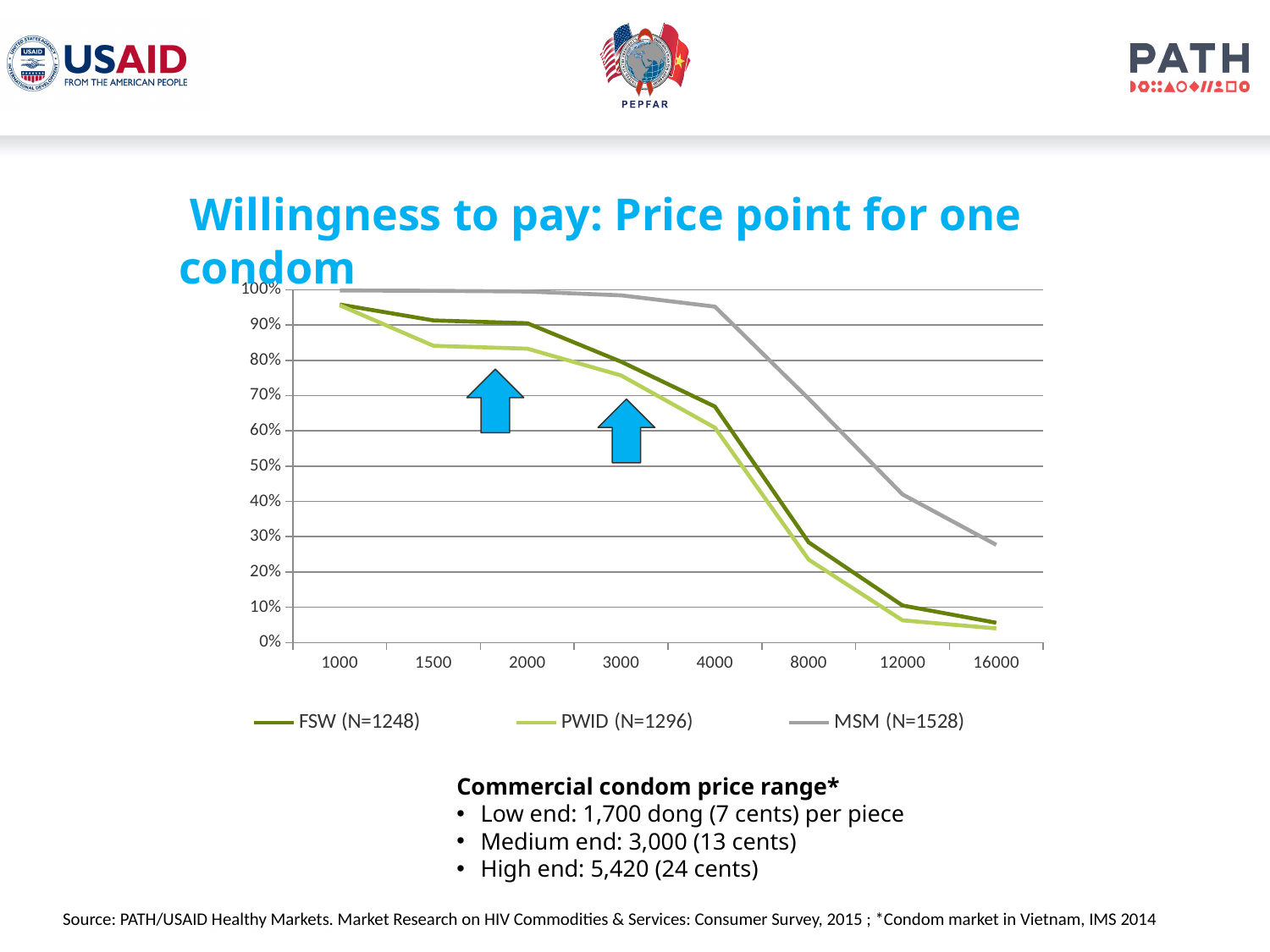
How many series does the legend list? 3 Is the value for PWID (N=1296) at the 1500 price point greater or less than 90%? less Do the values for the FSW (N=1248) series rise or fall as the price increases along the x axis? fall Is the value for FSW (N=1248) at the 4000 price point greater or less than 60%? greater At the 3000 price point, which is larger: the value for FSW (N=1248) or the value for PWID (N=1296)? FSW (N=1248) Is the value for MSM (N=1528) at the 12000 price point greater or less than 50%? less What is the title of the chart on the slide? Willingness to pay: Price point for one condom How many price points are shown on the x axis? 8 At the 8000 price point, which is larger: the value for MSM (N=1528) or the value for FSW (N=1248)? MSM (N=1528) Which series has the highest value at the 12000 price point? MSM (N=1528) Which series has the lowest value at the 8000 price point? PWID (N=1296) What kind of chart is shown on the slide? line chart